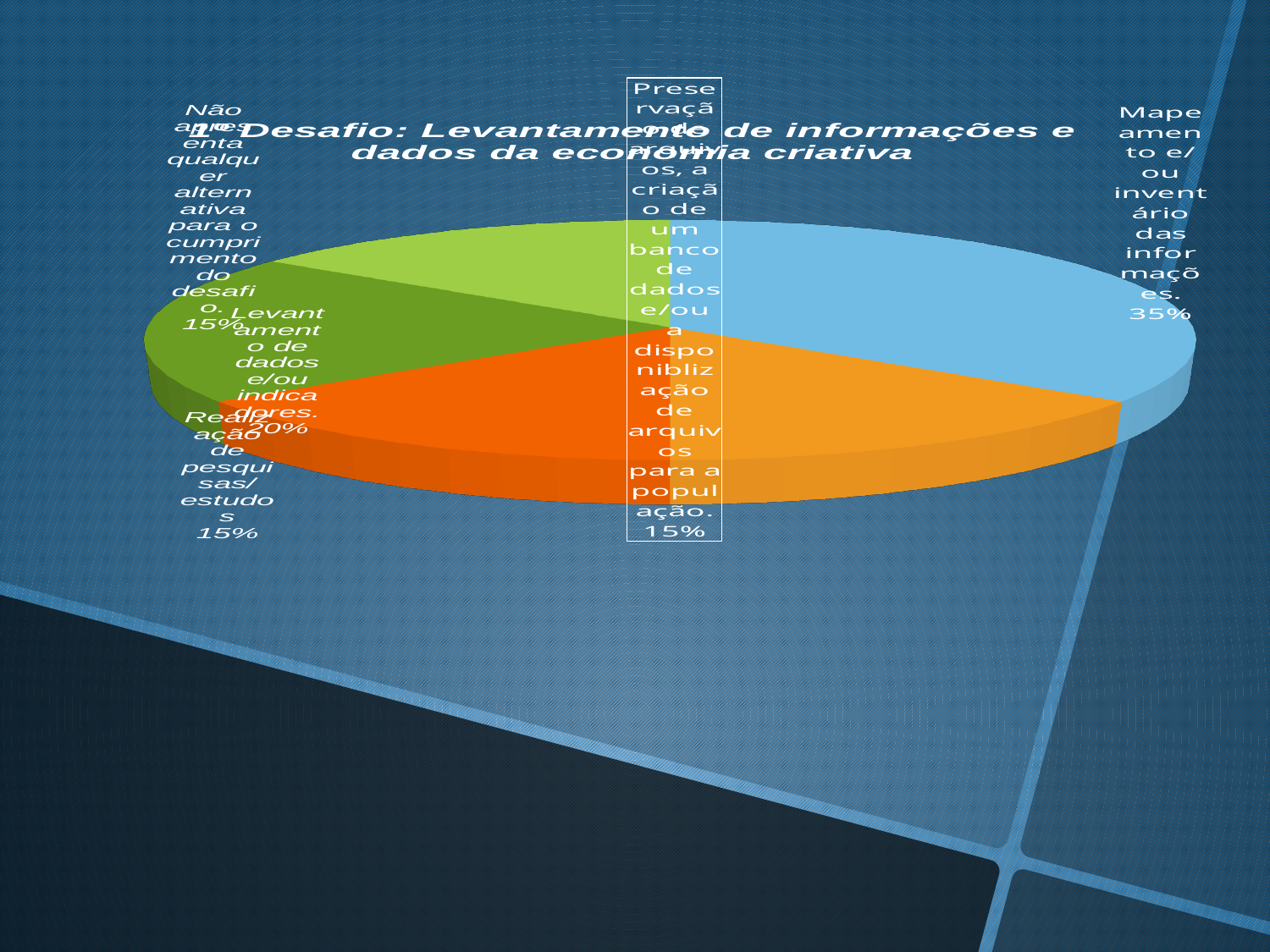
What is the difference in percentage points between "Mapeamento e/ou inventário das informações" and "Levantamento de dados e/ou indicadores"? 15 What is the title of the chart? 1º Desafio: Levantamento de informações e dados da economia criativa What percentage is shown for the slice about preservação de arquivos and criação de um banco de dados? 15% How many slices of the pie are labelled 15%? 3 What percentage is shown for "Realização de pesquisas/estudos"? 15% What percentage is shown for "Não apresenta qualquer alternativa para o cumprimento do desafio"? 15% What percentage is shown for "Mapeamento e/ou inventário das informações"? 35% How many slices does the pie chart have? 5 What kind of chart is shown on the slide? pie chart What percentage is shown for "Levantamento de dados e/ou indicadores"? 20% Which is larger: the share for "Mapeamento e/ou inventário das informações" or for "Levantamento de dados e/ou indicadores"? Mapeamento e/ou inventário das informações Which category has the largest share of the pie? Mapeamento e/ou inventário das informações